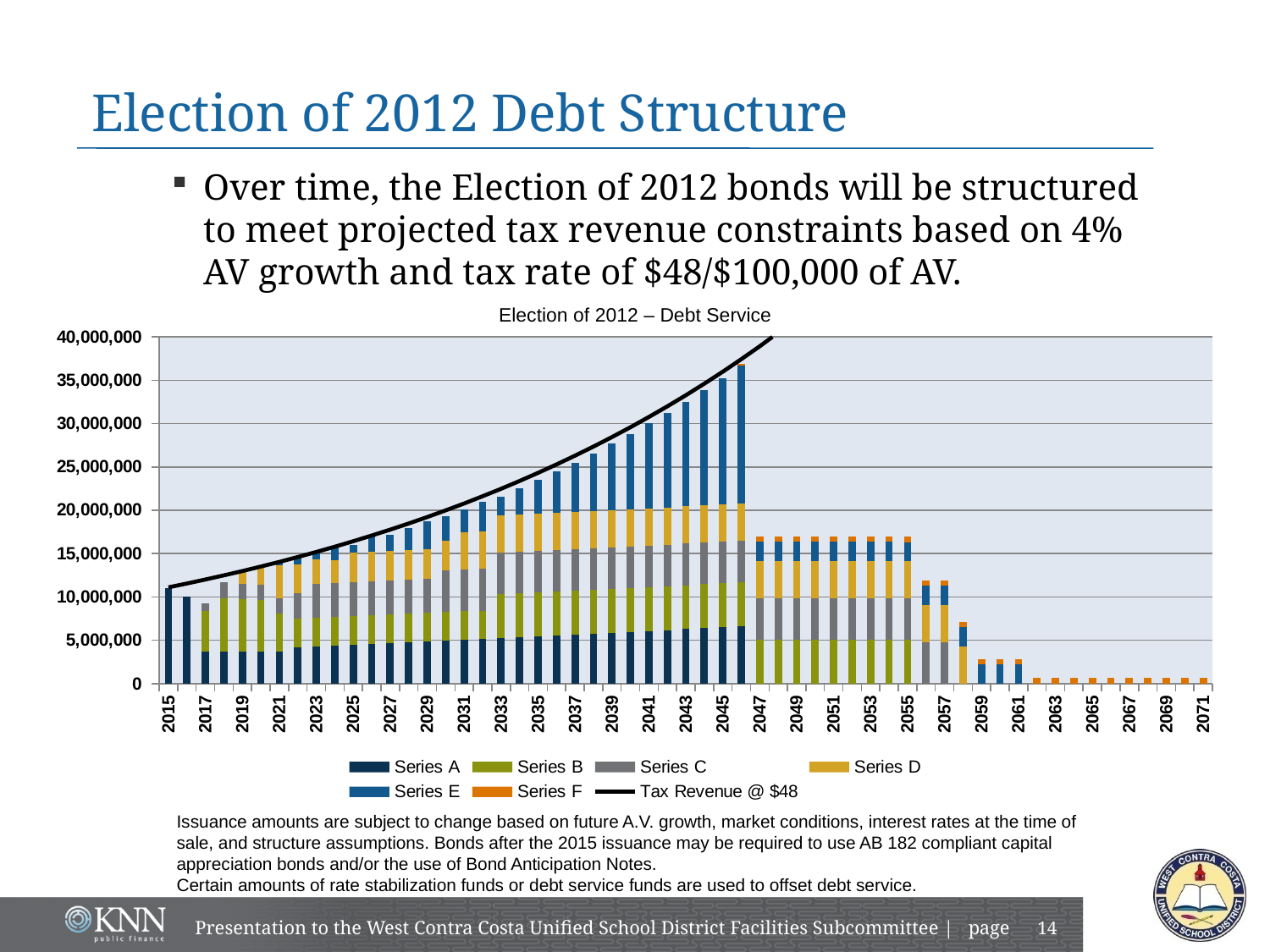
Which year has the taller total debt service bar, 2045 or 2047? 2045 Is the total debt service bar for 2045 greater or less than 30,000,000? greater What is the title of the chart? Election of 2012 – Debt Service Is the total debt service bar for 2047 greater or less than 20,000,000? less What kind of chart is shown on the slide? Stacked bar chart with a line What is the name of the line series plotted over the bars? Tax Revenue @ $48 Is the total debt service bar for 2059 greater or less than 5,000,000? less Does the Tax Revenue @ $48 line rise or fall from 2015 to 2046? rise Which year has the taller total debt service bar, 2055 or 2057? 2055 How many entries does the chart legend list? 7